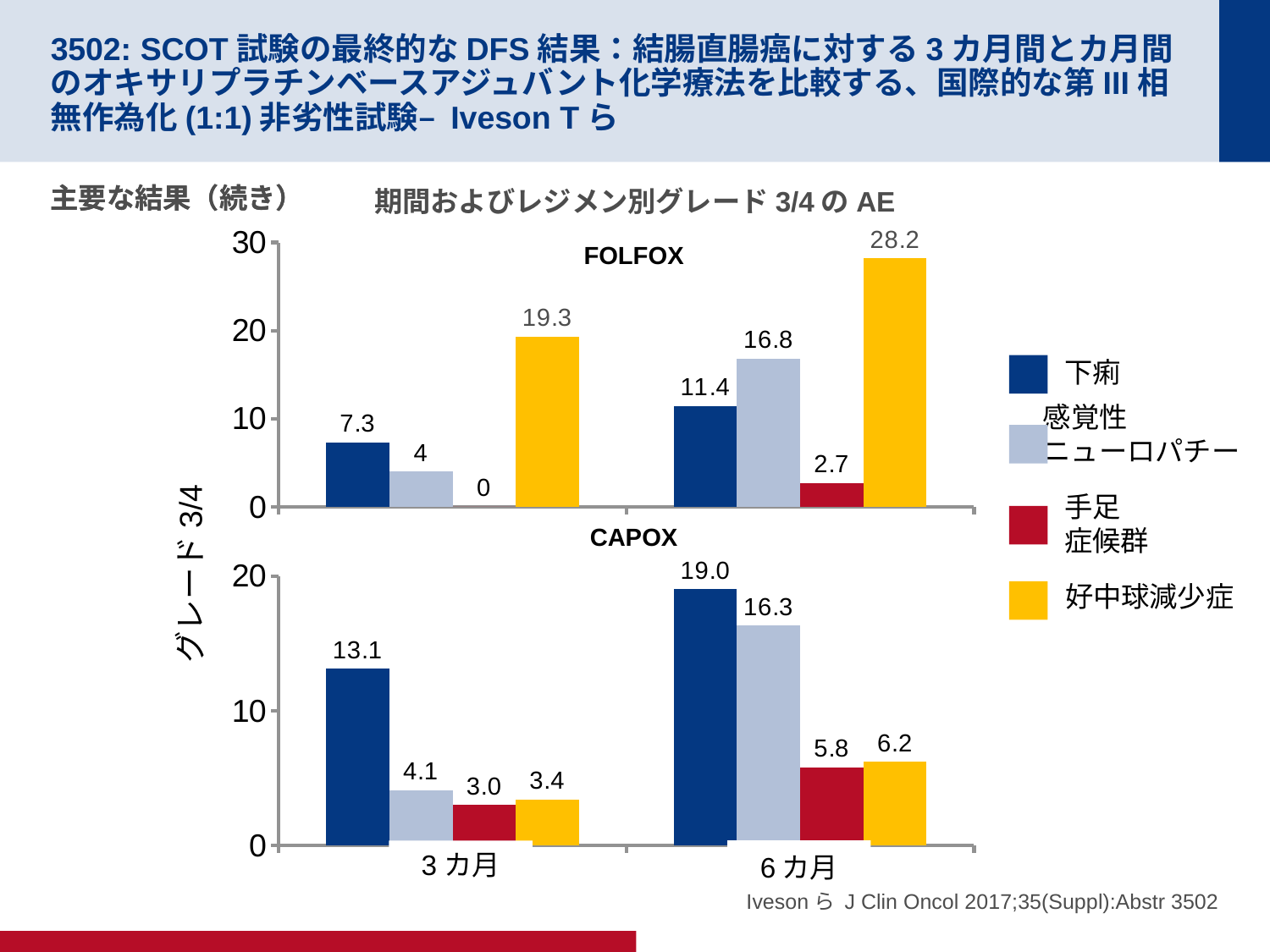
凡例にはいくつの系列が示されていますか？ 4 CAPOX のグラフで、3 カ月の中で最も低い値の AE はどれですか？ 手足症候群 CAPOX のグラフで、6 カ月の感覚性ニューロパチーの値はいくつですか？ 16.3 FOLFOX のグラフで、6 カ月の中で最も高い値の AE はどれですか？ 好中球減少症 FOLFOX のグラフで、6 カ月の感覚性ニューロパチーの値は 10 より大きいですか、小さいですか？ greater FOLFOX のグラフで、好中球減少症の 6 カ月と 3 カ月の値の差はいくつですか？ 8.9 CAPOX のグラフで、3 カ月の下痢の値はいくつですか？ 13.1 FOLFOX のグラフはどの種類のグラフですか？ bar chart CAPOX のグラフで、手足症候群の値は 3 カ月から 6 カ月にかけて上昇していますか、下降していますか？ 上昇 FOLFOX のグラフで、6 カ月の好中球減少症の値はいくつですか？ 28.2 CAPOX のグラフで、6 カ月の下痢と 3 カ月の下痢ではどちらが大きいですか？ 6 カ月 FOLFOX のグラフで、3 カ月の手足症候群の値はいくつですか？ 0